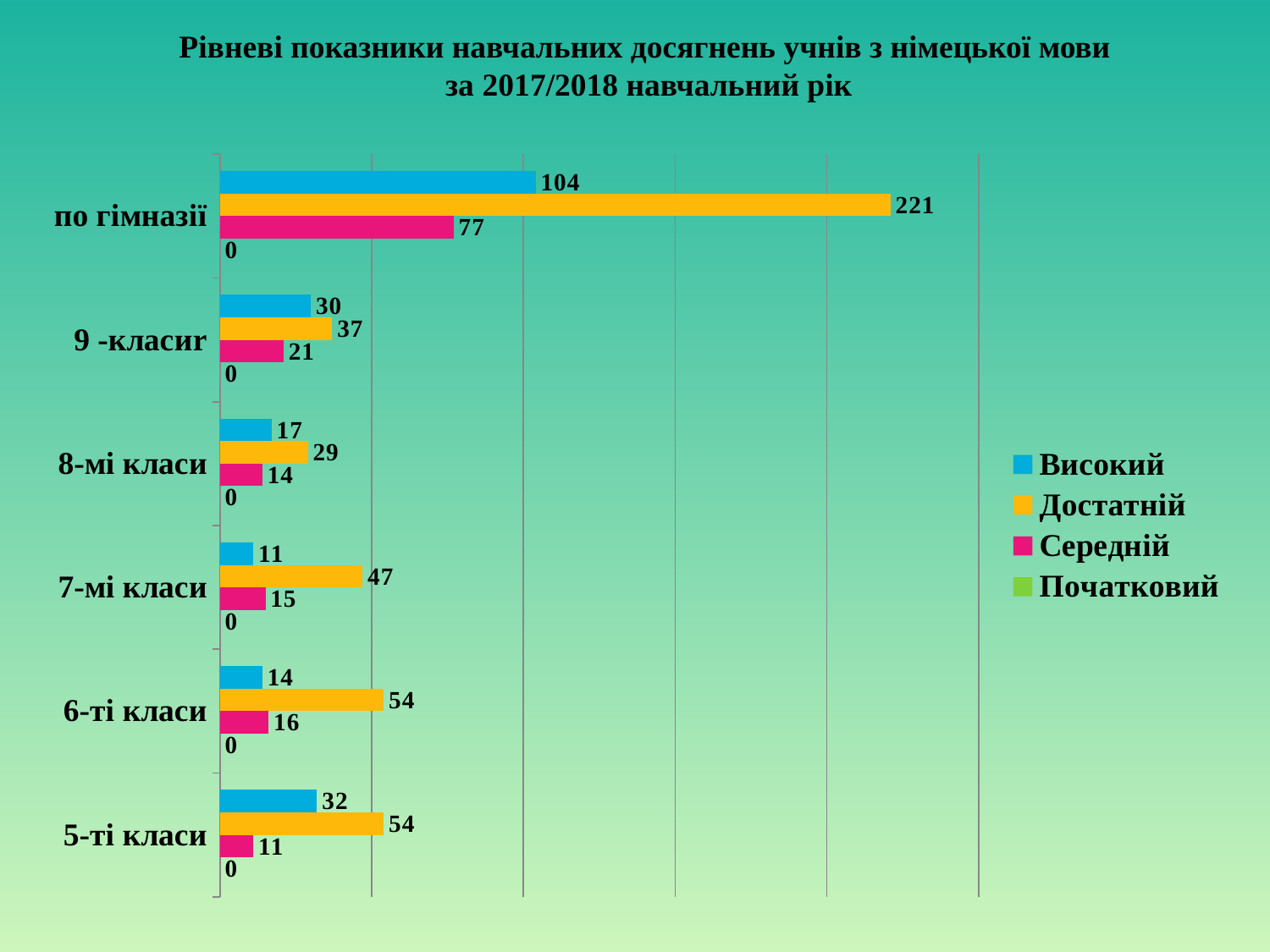
What is the value of Середній for 9-класи? 21 What is the value of Початковий for 7-мі класи? 0 Which colour represents the Середній series in the legend? Pink Which is larger: the Високий value for 9-класи or the Високий value for 8-мі класи? 9-класи What is the difference between the Достатній and Високий values for по гімназії? 117 Among the class groups (excluding по гімназії), which has the lowest Високий value? 7-мі класи How many categories are shown on the chart? 6 What is the value of Високий for 5-ті класи? 32 What is the value of Достатній for по гімназії? 221 What kind of chart is shown on the slide? Bar chart Which category has the highest Достатній value? по гімназії How many series does the legend list? 4